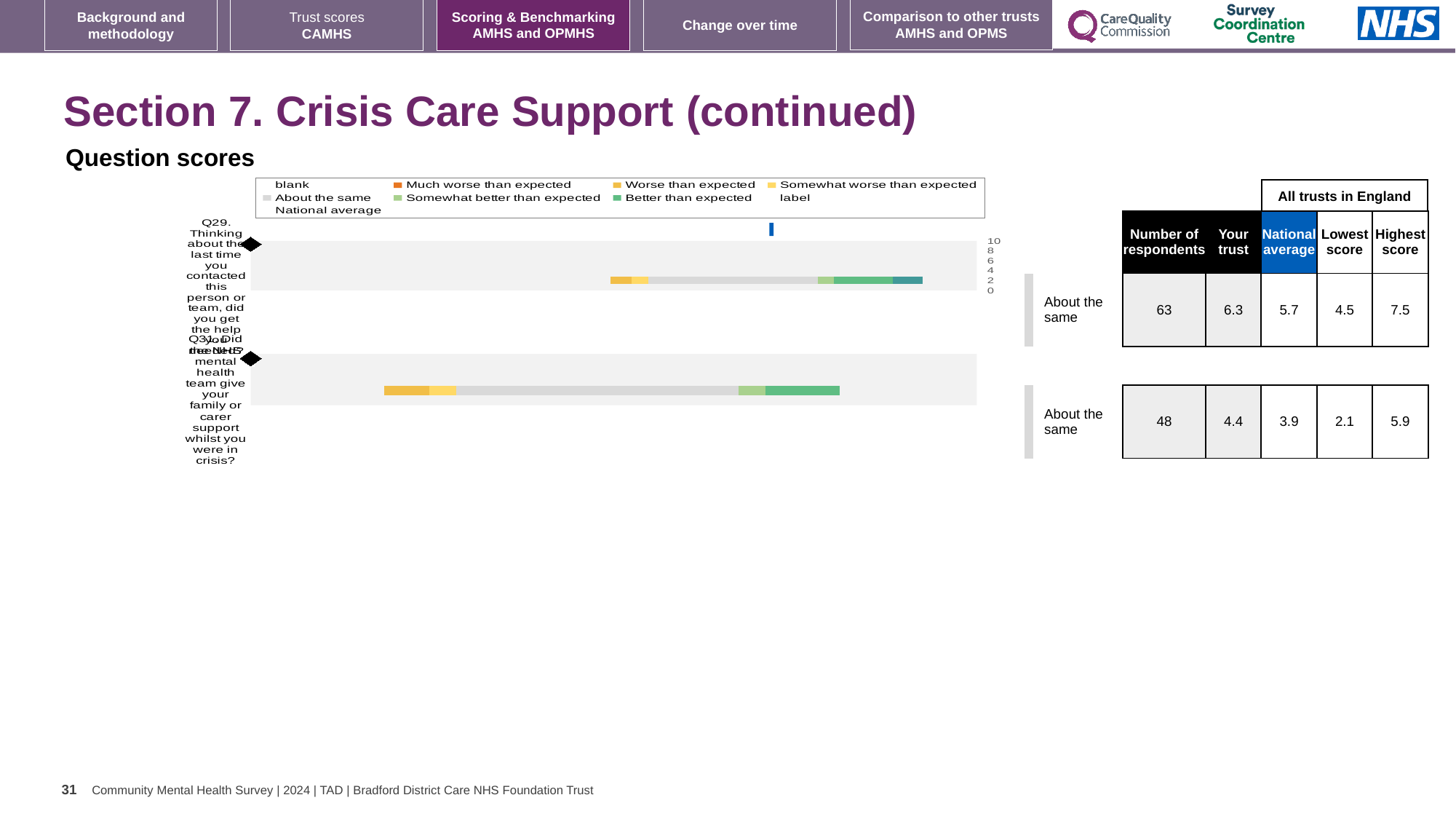
What kind of chart is shown under 'Question scores'? bar chart What is the number of respondents for Q31 in the table beside the chart? 48 What is the difference between the 'Your trust' score and the national average for Q29? 0.6 What benchmark category is given for Q29 next to the chart? About the same Which legend entry is shown in grey in the chart? About the same What is the highest score across all trusts in England for Q31? 5.9 Which question has the higher 'Your trust' score, Q29 or Q31? Q29 How many questions (bars) are plotted in the chart? 2 What is the national average for Q29 in the table beside the chart? 5.7 How many entries does the chart legend list? 9 What is the 'Your trust' score for Q31 in the table beside the chart? 4.4 What is the 'Your trust' score for Q29 in the table beside the chart? 6.3